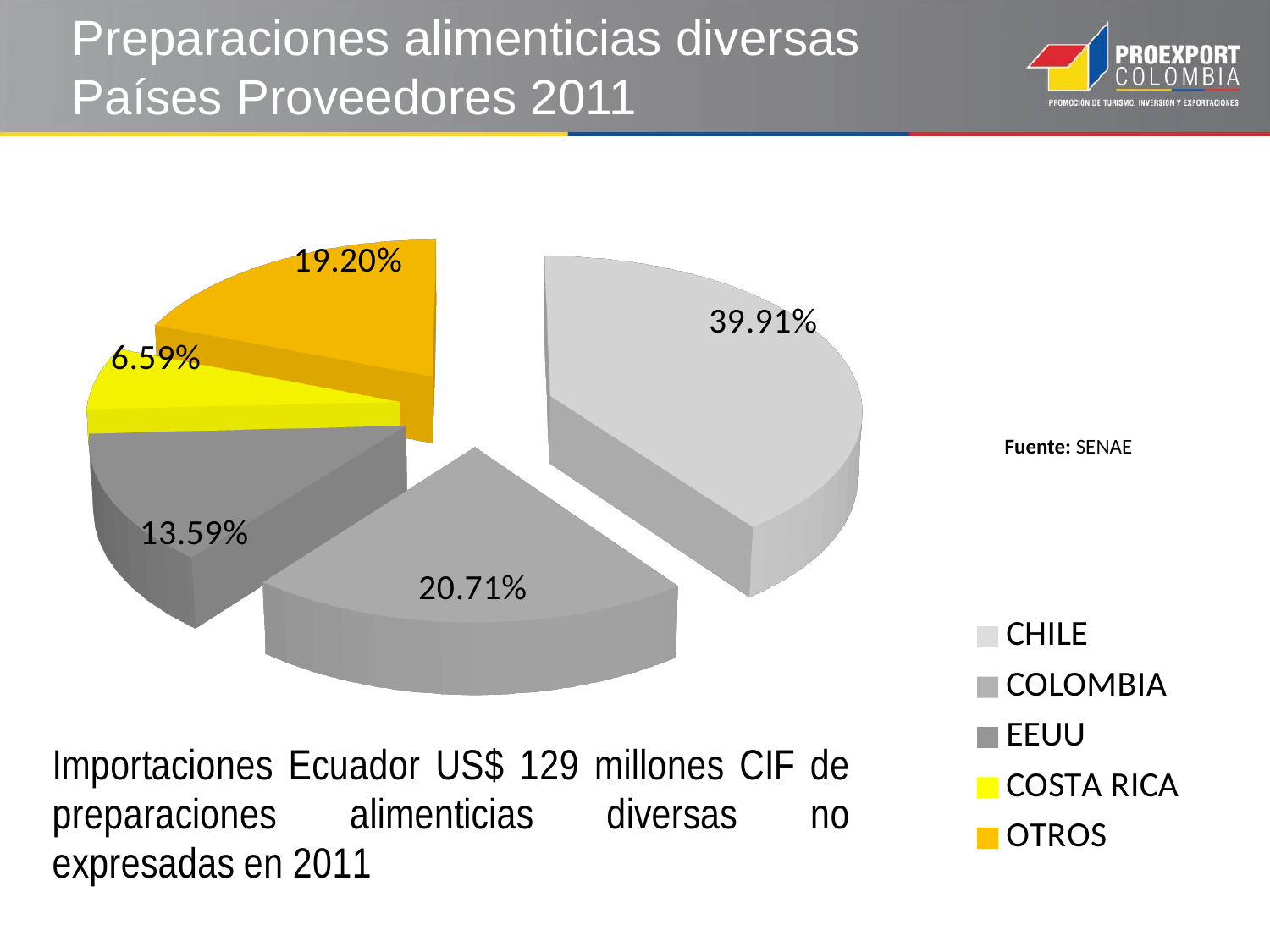
Which category has the smallest slice of the pie? COSTA RICA What share of the pie does CHILE hold? 39.91% What share of the pie does EEUU hold? 13.59% How many slices does the pie chart have? 5 What share of the pie does OTROS hold? 19.20% What kind of chart is shown on the slide? Pie chart Which slice is larger, COLOMBIA or OTROS? COLOMBIA What share of the pie does COSTA RICA hold? 6.59% What is the difference in percentage points between the CHILE and COLOMBIA slices? 19.20 Which legend entry is shown in yellow? COSTA RICA Which category has the largest slice of the pie? CHILE What share of the pie does COLOMBIA hold? 20.71%